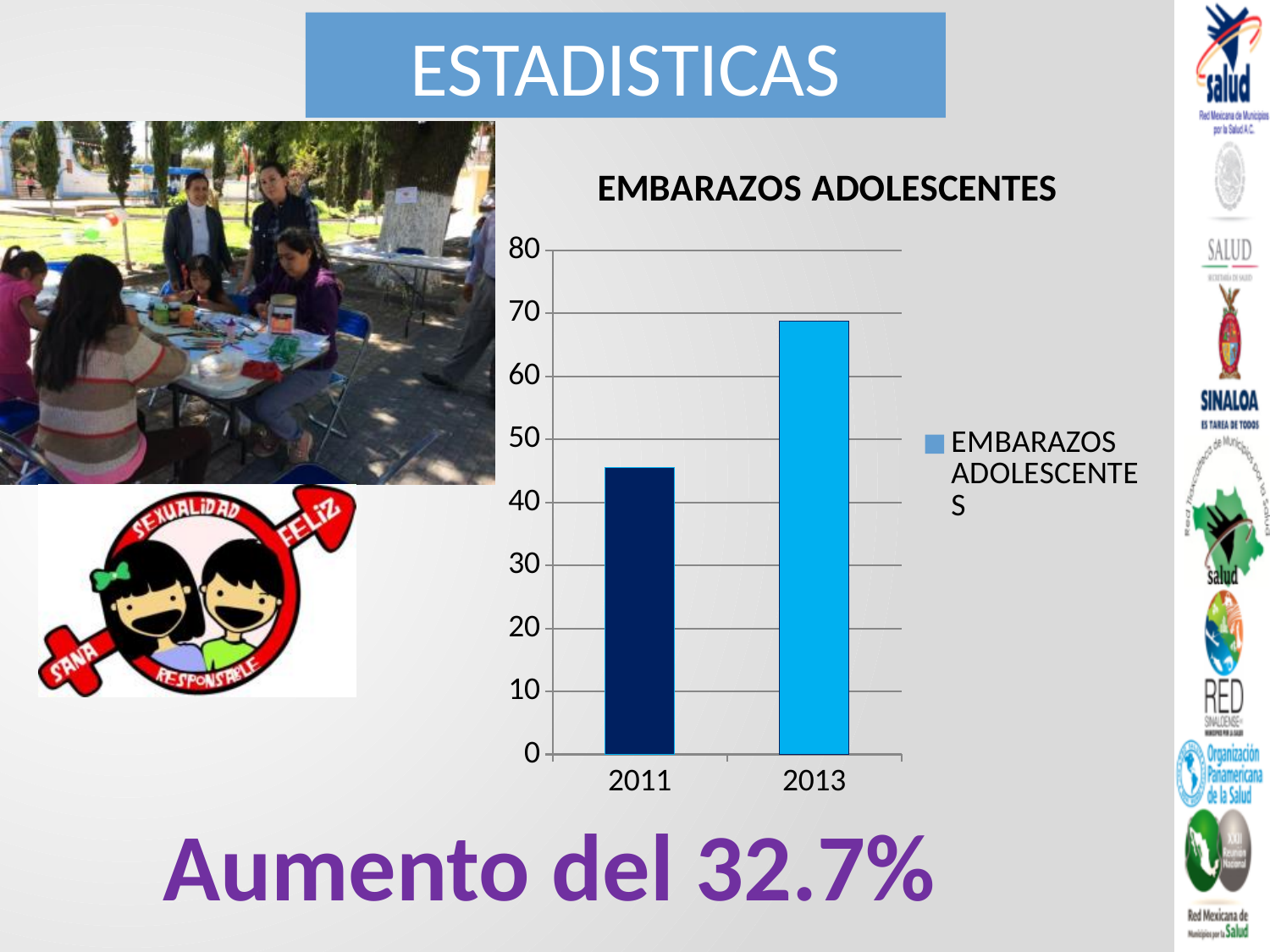
What is the title of the chart on the slide? EMBARAZOS ADOLESCENTES Which year has the highest value in the EMBARAZOS ADOLESCENTES chart? 2013 How many series does the legend of the EMBARAZOS ADOLESCENTES chart list? 1 How many categories are plotted on the x axis of the EMBARAZOS ADOLESCENTES chart? 2 What kind of chart is shown under the title EMBARAZOS ADOLESCENTES? bar chart In the EMBARAZOS ADOLESCENTES chart, which is larger, the value for 2011 or the value for 2013? 2013 Is the value for 2013 in the EMBARAZOS ADOLESCENTES chart greater or less than 60? greater Is the value for 2011 in the EMBARAZOS ADOLESCENTES chart greater or less than 40? greater Is the value for 2011 in the EMBARAZOS ADOLESCENTES chart greater or less than 50? less Which year has the lowest value in the EMBARAZOS ADOLESCENTES chart? 2011 Do the values in the EMBARAZOS ADOLESCENTES chart rise or fall from 2011 to 2013? rise